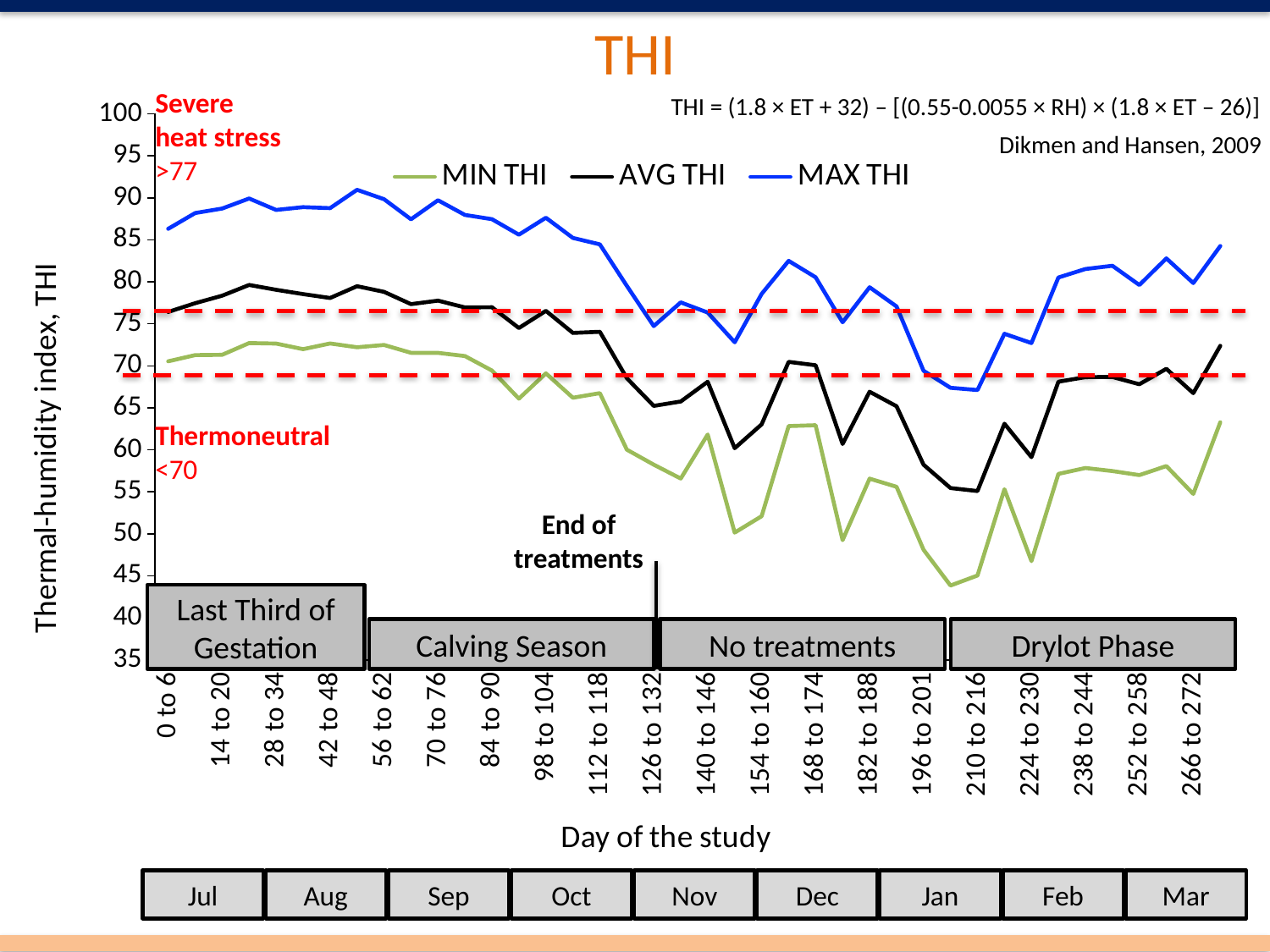
What kind of chart is shown on the slide? Line chart What is the title of the vertical axis? Thermal-humidity index, THI How many series does the legend list? 3 Is the AVG THI value for days 196 to 201 greater or less than 60? less At days 126 to 132, which is larger, MAX THI or MIN THI? MAX THI Is the MAX THI value for days 0 to 6 greater or less than 80? greater Is the MIN THI value for days 154 to 160 greater or less than 60? less Which series is plotted with the blue line? MAX THI Does the MAX THI line rise or fall overall from days 0 to 6 to days 196 to 201? fall Which series has the highest values throughout the study? MAX THI